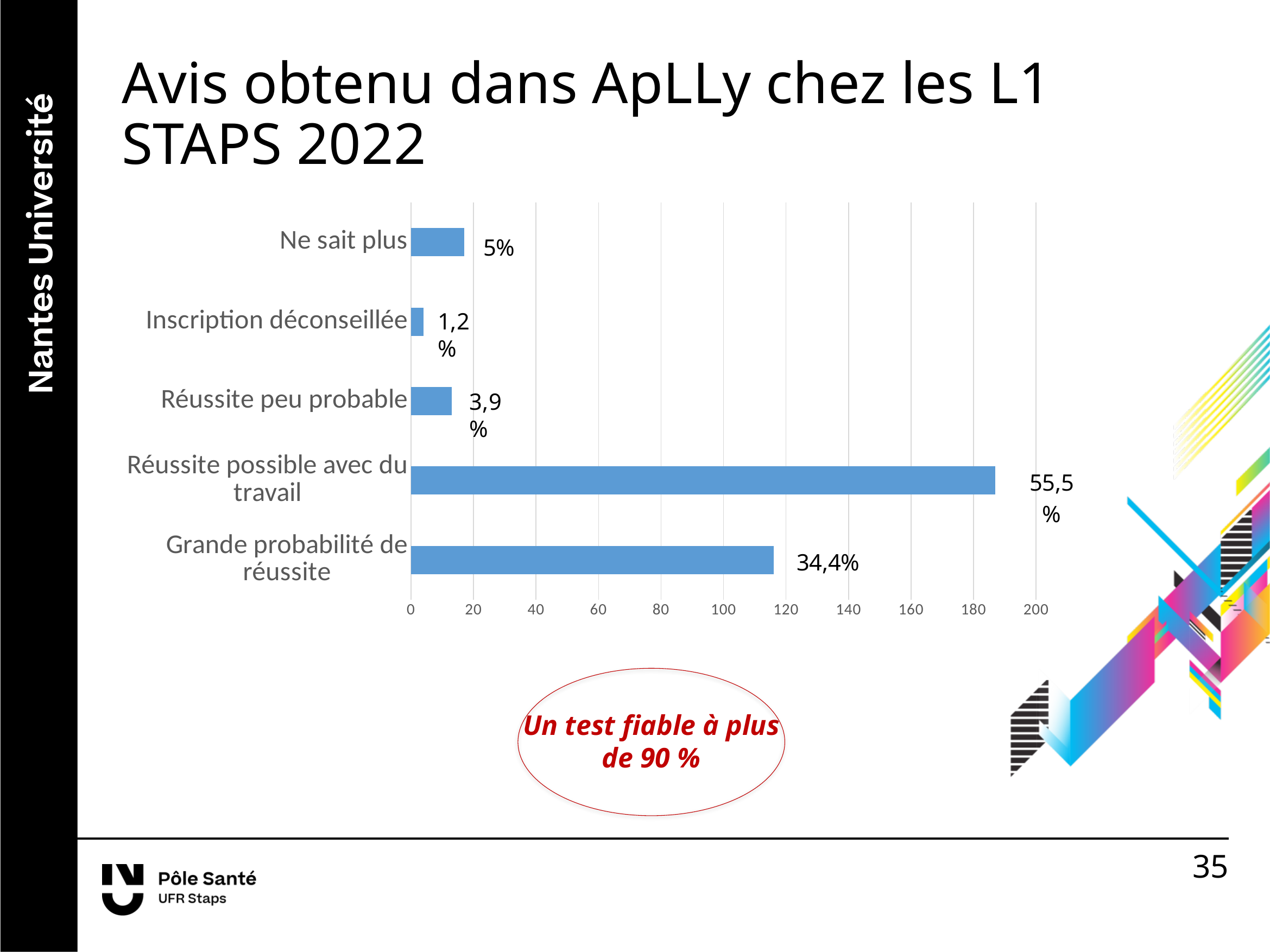
What data label is shown for "Ne sait plus"? 5% What data label is shown for "Grande probabilité de réussite"? 34,4% What data label is shown for "Réussite peu probable"? 3,9 % What data label is shown for "Réussite possible avec du travail"? 55,5 % What kind of chart is shown on the slide? Bar chart What data label is shown for "Inscription déconseillée"? 1,2 % Which category has the shortest bar? Inscription déconseillée Is the value for "Réussite possible avec du travail" on the horizontal axis greater or less than 180? greater What is the difference in percentage points between the labels for "Réussite possible avec du travail" and "Grande probabilité de réussite"? 21,1 How many categories are shown in the chart? 5 Which is larger, the bar for "Ne sait plus" or the bar for "Réussite peu probable"? Ne sait plus Which category has the longest bar? Réussite possible avec du travail